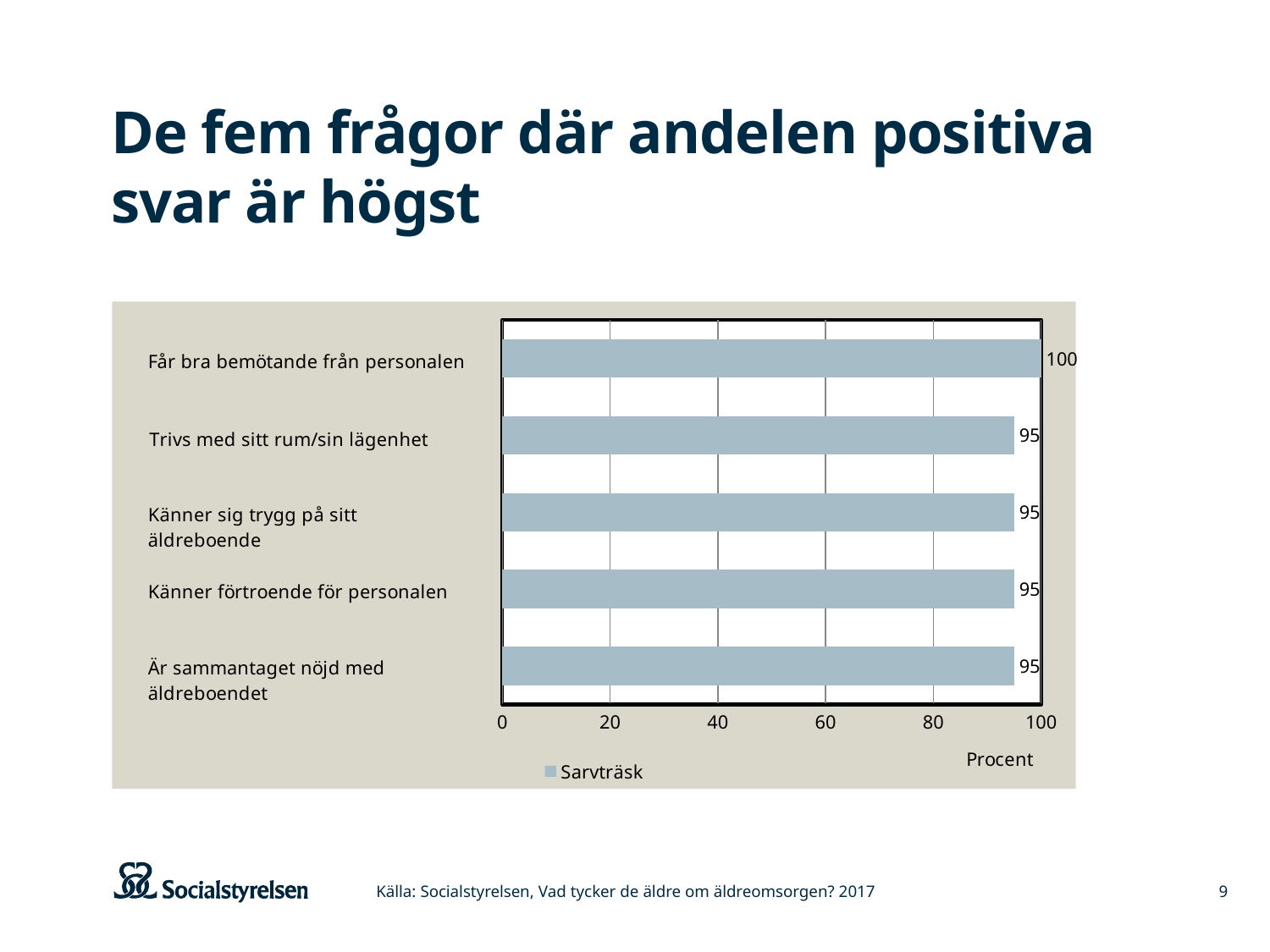
What series name is shown in the legend? Sarvträsk What is the difference between the values for "Får bra bemötande från personalen" and "Känner sig trygg på sitt äldreboende"? 5 What is the value for "Trivs med sitt rum/sin lägenhet"? 95 How many series does the legend list? 1 How many categories are shown in the chart? 5 Is the value for "Känner sig trygg på sitt äldreboende" greater or less than 80? greater Which is larger, the value for "Får bra bemötande från personalen" or the value for "Trivs med sitt rum/sin lägenhet"? Får bra bemötande från personalen What is the value for "Får bra bemötande från personalen"? 100 What is the value for "Är sammantaget nöjd med äldreboendet"? 95 What is the value for "Känner förtroende för personalen"? 95 Which category has the highest value? Får bra bemötande från personalen What kind of chart is shown on the slide? bar chart